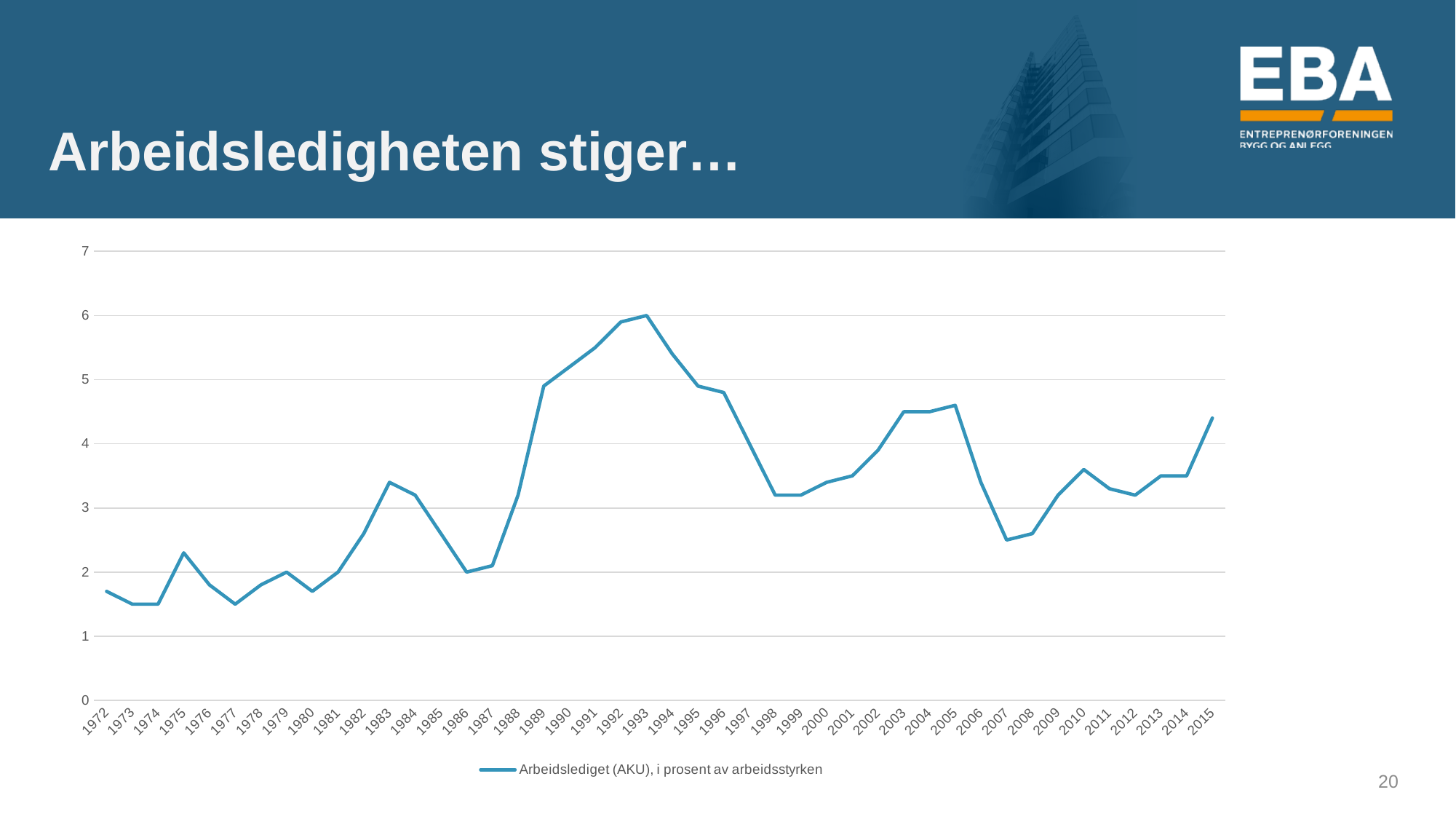
Is the value for 2007 greater or less than 3? less What kind of chart is shown on the slide? line chart In which year does the unemployment rate reach its highest value? 1993 Does the unemployment rate rise or fall between 2007 and 2015? rise How many series does the legend list? 1 What is the legend entry for the plotted series? Arbeidslediget (AKU), i prosent av arbeidsstyrken How many years are plotted along the x axis? 44 Which year has the higher unemployment rate, 1989 or 2005? 1989 What is the title of the slide containing the chart? Arbeidsledigheten stiger… Is the value for 1993 greater or less than 5? greater Is the value for 1977 greater or less than 2? less